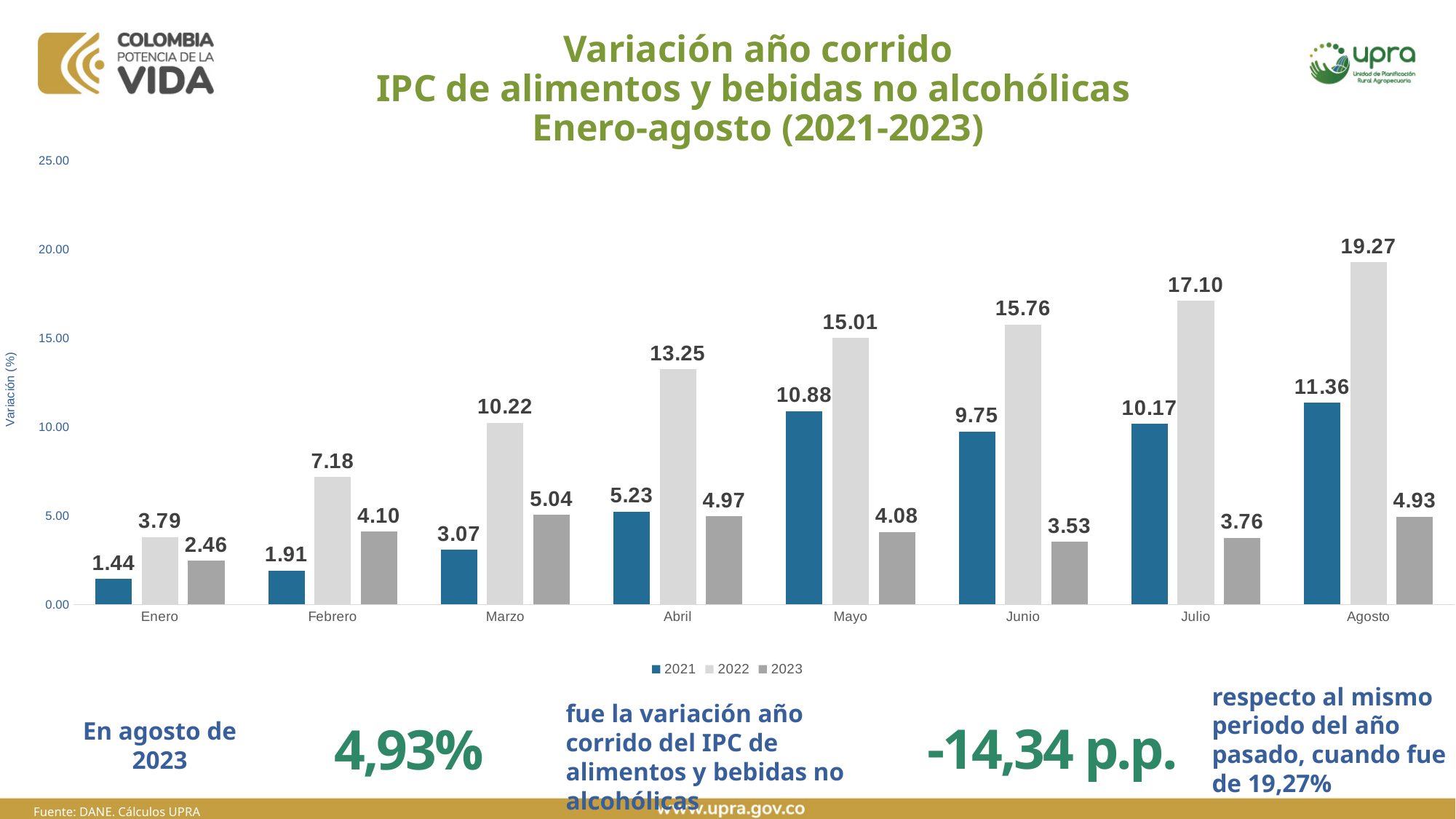
Which month has the lowest value for the 2021 series? Enero How many series does the legend list? 3 Which is larger in Abril: the value for 2021 or the value for 2023? 2021 What is the value for 2021 in Mayo? 10.88 How many months are shown on the x axis? 8 Is the value for 2022 in Julio greater or less than 15.00? greater What is the value for 2023 in Febrero? 4.10 What kind of chart is shown on the slide? Bar chart Does the 2022 series rise or fall from Enero to Agosto? Rise What is the difference between the 2022 and 2023 values in Agosto? 14.34 What is the value for 2022 in Agosto? 19.27 Which month has the highest value for the 2022 series? Agosto